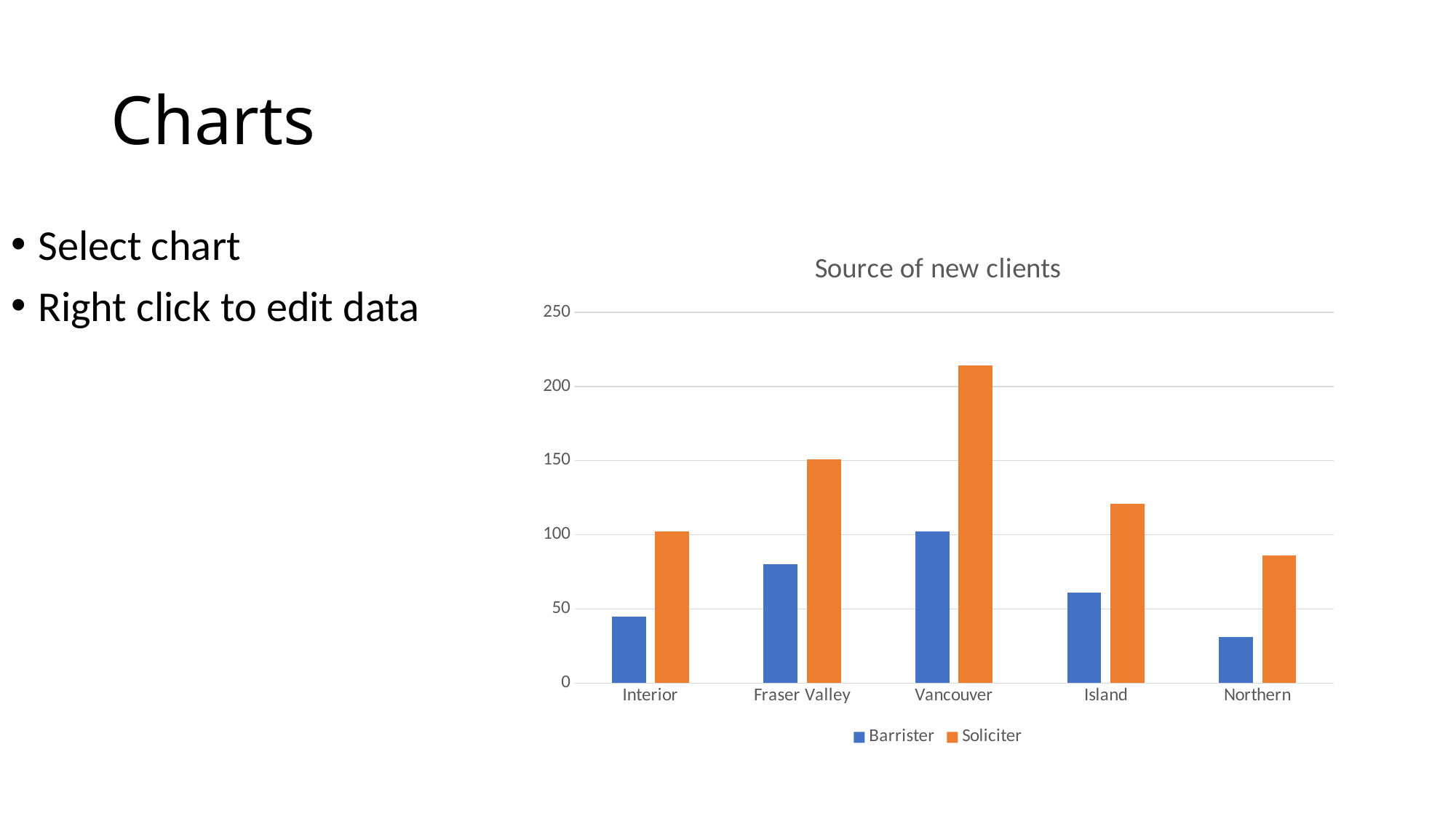
Which category has the lowest Barrister value? Northern Which is larger: the Soliciter value for Fraser Valley or the Soliciter value for Island? Fraser Valley What is the title of the chart? Source of new clients Is the Barrister value for Interior greater or less than 50? less Is the Soliciter value for Vancouver greater or less than 200? greater Is the Soliciter value for Island greater or less than 100? greater Which is larger: the Barrister value for Interior or the Barrister value for Island? Island Which category has the highest Soliciter value? Vancouver How many series does the legend list? 2 Which category has the highest Barrister value? Vancouver What type of chart is shown on the slide? Bar chart How many categories are shown on the x axis? 5